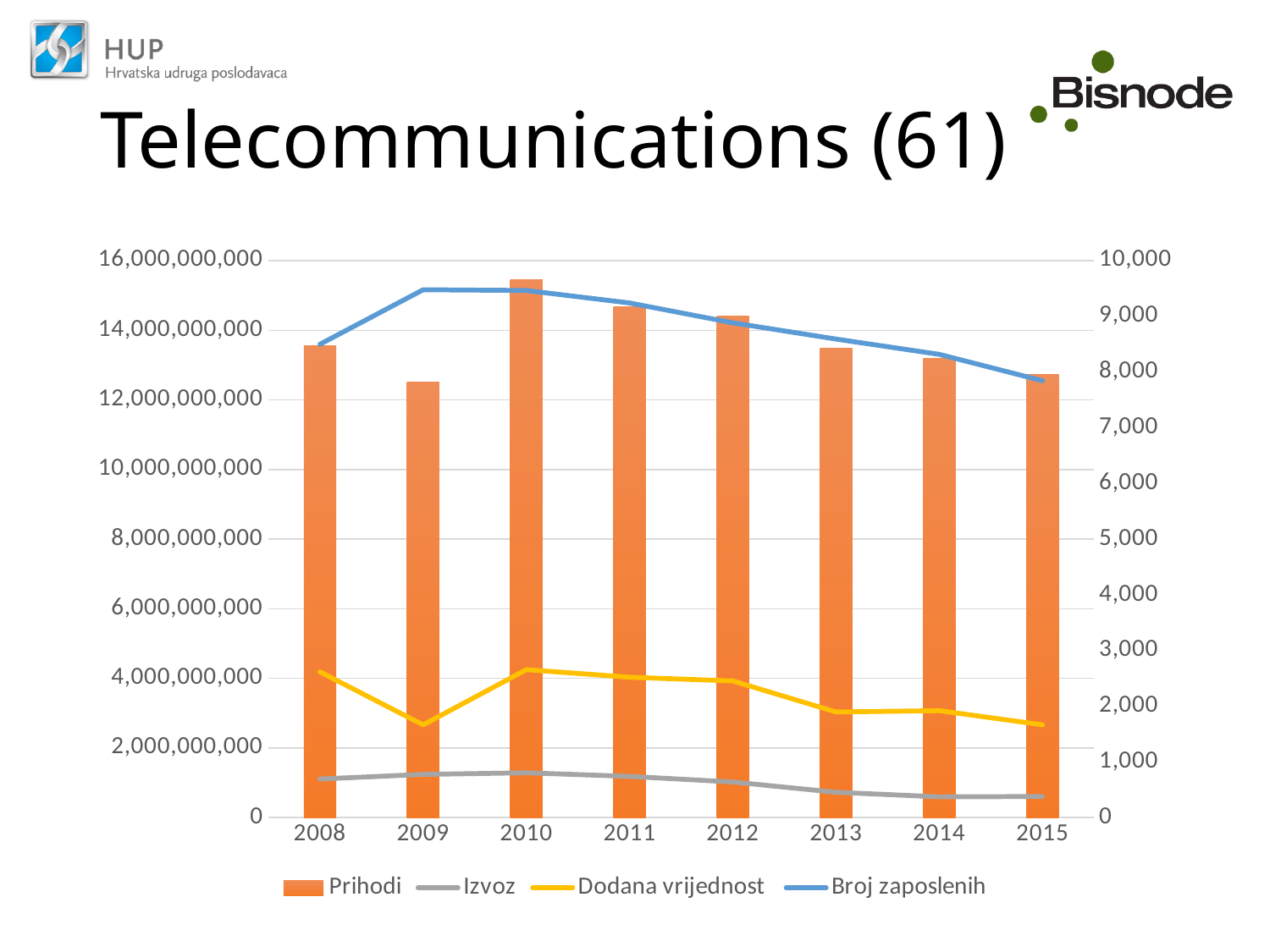
In which year is the Broj zaposlenih line at its lowest? 2015 Is the Izvoz value for 2015 greater or less than 2,000,000,000? less Is the Prihodi value for 2010 greater or less than 14,000,000,000? greater How many series does the chart legend list? 4 In which year is the Prihodi bar the highest? 2010 Is the Broj zaposlenih value for 2010 greater or less than 9,000? greater Which year has the larger Prihodi value, 2008 or 2009? 2008 What kind of chart is shown on the slide? A combination bar and line chart In which year is the Prihodi bar the lowest? 2009 Does the Broj zaposlenih line rise or fall from 2010 to 2015? fall How many years are shown on the x axis of the chart? 8